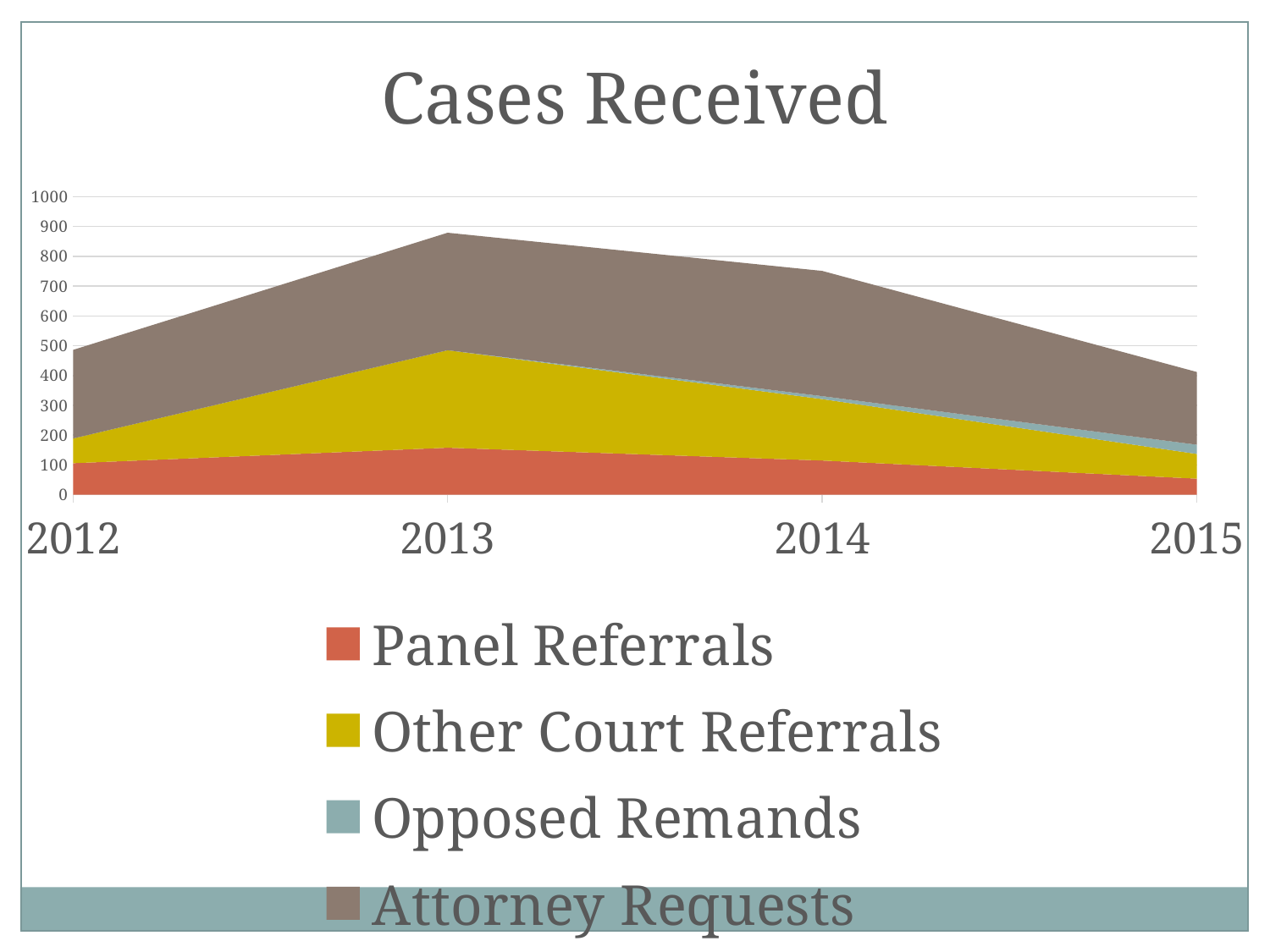
In which year is the total of all stacked series lowest? 2015 Is the total stacked value for 2013 greater or less than 800? greater Is the total stacked value for 2015 greater or less than 300? greater How many years are plotted along the x axis? 4 Is the value for Panel Referrals in 2015 greater or less than 100? less What kind of chart is shown on the slide? Stacked area chart What is the title of the chart? Cases Received In which year is the total of all stacked series highest? 2013 How many series does the legend list? 4 How does the total of cases received change from 2013 to 2015? It falls Which series is shown in the topmost (brown) band of the chart? Attorney Requests